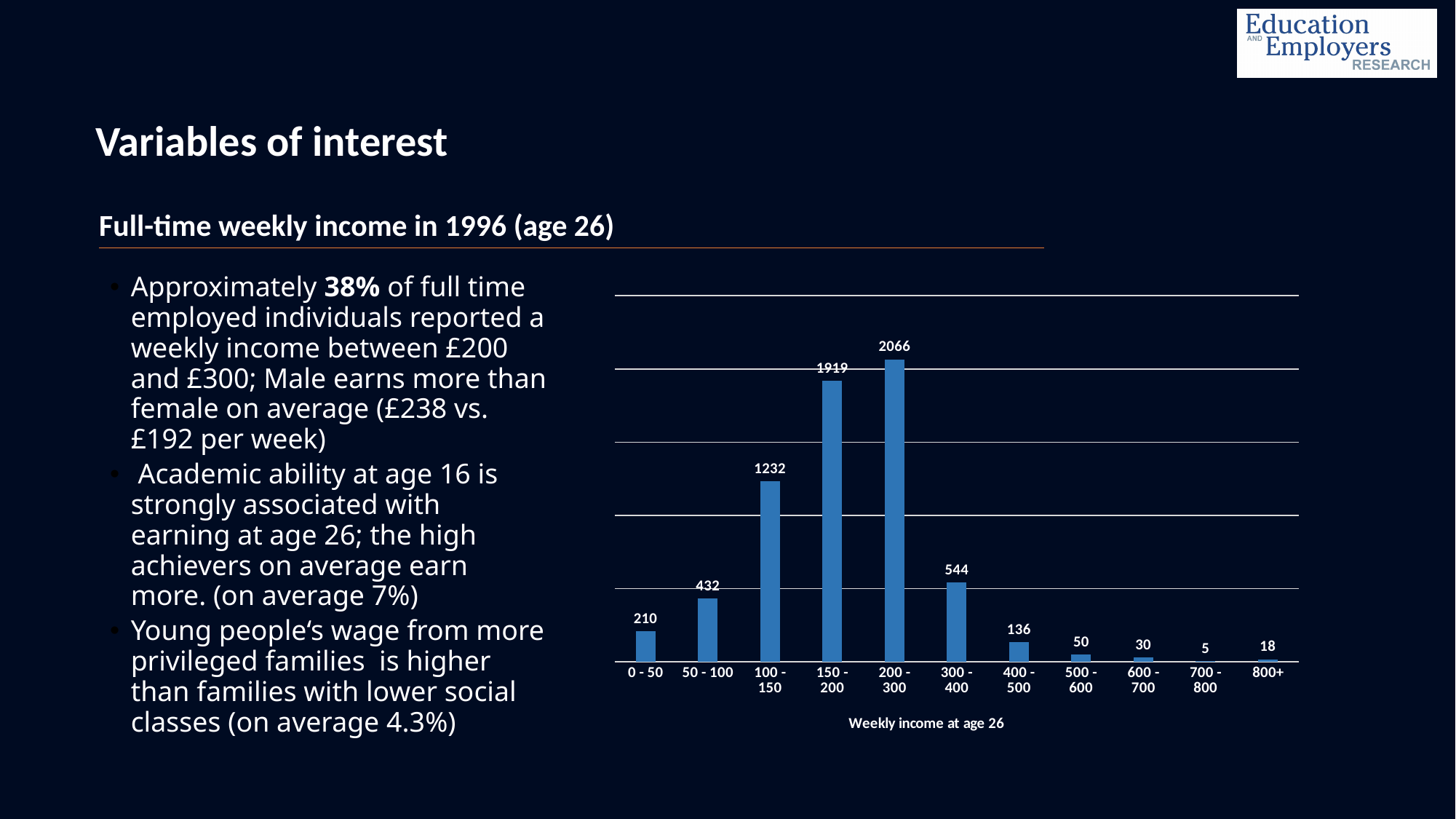
Which is larger, the value for 50 - 100 or the value for 300 - 400? 300 - 400 What is the x-axis title of the chart? Weekly income at age 26 Which weekly income category has the lowest value? 700 - 800 What is the value for the 0 - 50 weekly income category? 210 What is the difference between the values for 300 - 400 and 400 - 500? 408 What kind of chart is shown on the slide? Bar chart What is the value for the 800+ weekly income category? 18 Do the values rise or fall along the x axis from 200 - 300 to 800+? Fall Which weekly income category has the highest value? 200 - 300 What is the difference between the values for 200 - 300 and 150 - 200? 147 What is the value for the 200 - 300 weekly income category? 2066 How many weekly income categories are shown on the x axis? 11